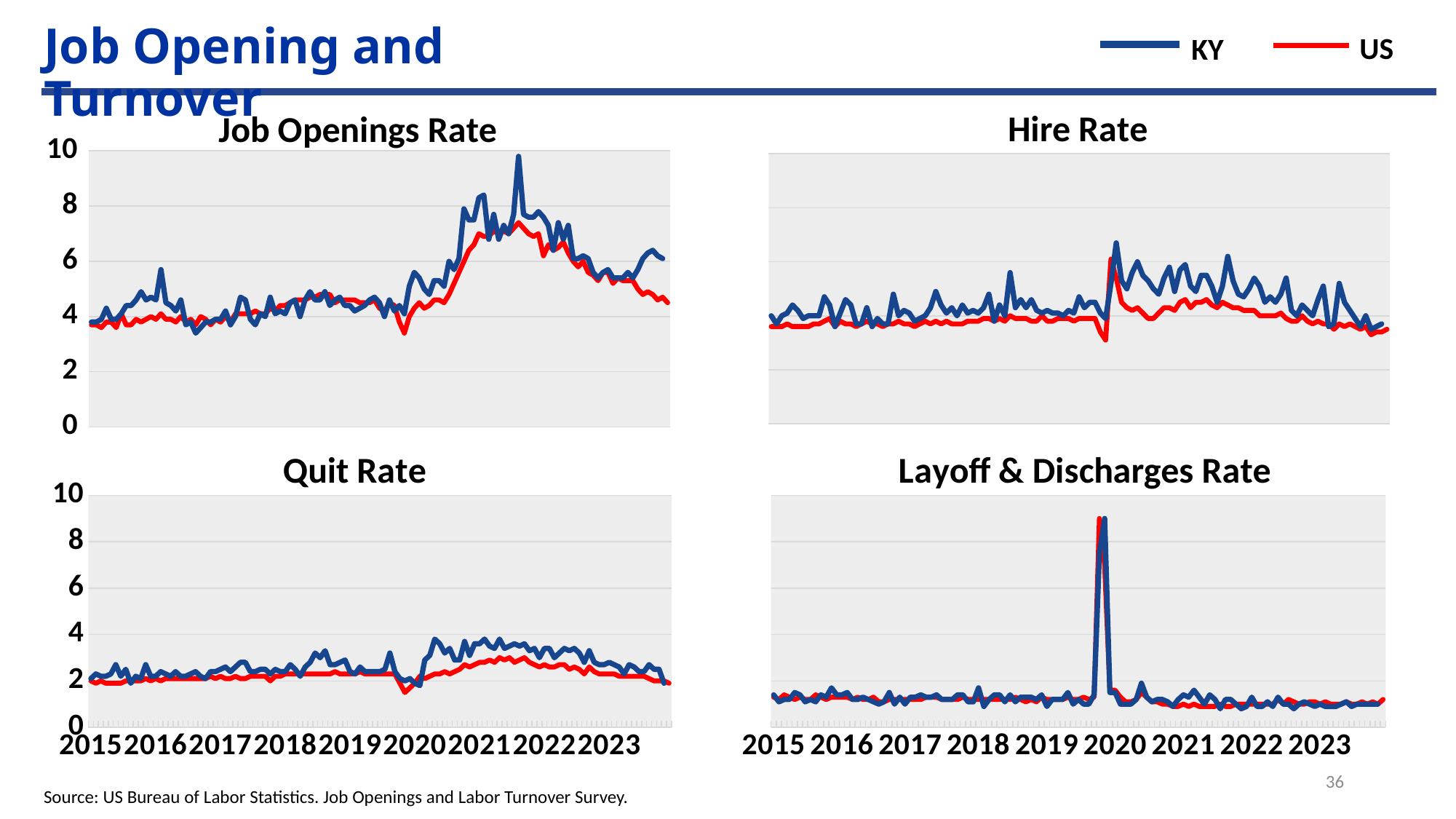
In the Job Openings Rate chart, does the US series rise or fall from 2022 to 2023? fall In the Hire Rate chart, is the highest value of the KY series greater or less than 6? greater What is the title of the chart in the bottom-right position of the slide? Layoff & Discharges Rate In the Job Openings Rate chart, which series reaches the higher peak in 2021, KY or US? KY How many series does the legend at the top of the slide list? 2 How many charts are shown on the slide? 4 In the Quit Rate chart, is the US series ever greater than 4? No In the Quit Rate chart, which series is higher during 2021, KY or US? KY Which colour represents the US series in the charts? red In the Job Openings Rate chart, is the peak value of the KY series in 2021 greater or less than 8? greater What kind of chart is the Job Openings Rate chart? line chart